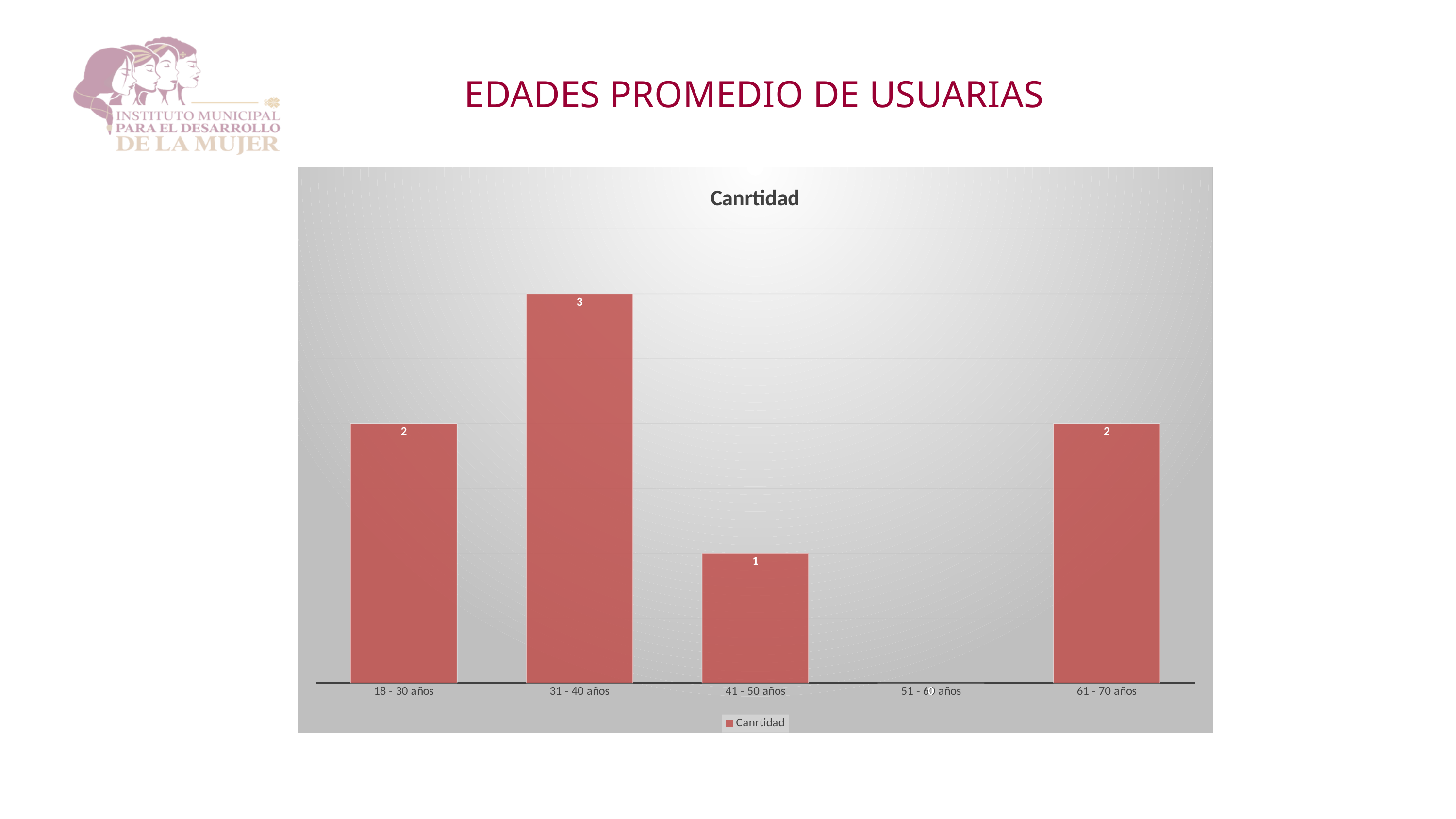
What kind of chart is shown on the slide? Bar chart What is the value for 51 - 60 años? 0 What is the value for 61 - 70 años? 2 What is the title of the chart? Canrtidad What is the difference between the values for 31 - 40 años and 41 - 50 años? 2 What is the value for 41 - 50 años? 1 Which is larger, the value for 31 - 40 años or the value for 61 - 70 años? 31 - 40 años What is the value for 18 - 30 años? 2 How many age categories are shown on the x axis? 5 Which age group has the lowest value? 51 - 60 años Which age group has the highest value? 31 - 40 años What is the value for 31 - 40 años? 3